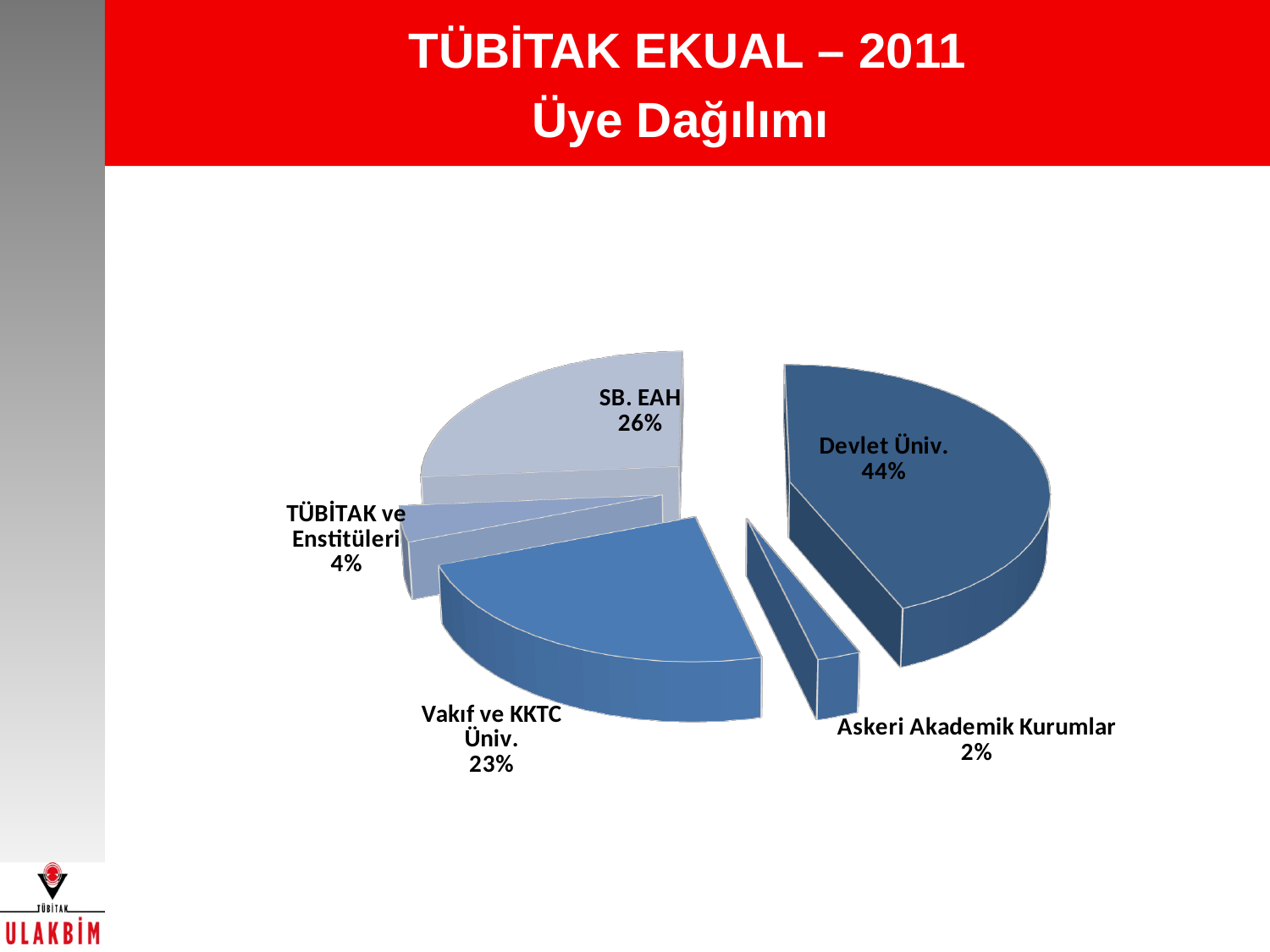
What is the difference in percentage points between Devlet Üniv. and SB. EAH? 18 What percentage is shown for Askeri Akademik Kurumlar? 2% Which category has the largest slice of the pie? Devlet Üniv. What kind of chart is shown on the slide? Pie chart Which is larger, the share for SB. EAH or the share for Vakıf ve KKTC Üniv.? SB. EAH How many categories are shown in the pie chart? 5 What percentage is shown for Vakıf ve KKTC Üniv.? 23% What share is shown for TÜBİTAK ve Enstitüleri? 4% What share of members does Devlet Üniv. hold? 44% What is the title of the slide containing the chart? TÜBİTAK EKUAL – 2011 Üye Dağılımı What percentage is shown for SB. EAH? 26% Which category has the smallest slice of the pie? Askeri Akademik Kurumlar